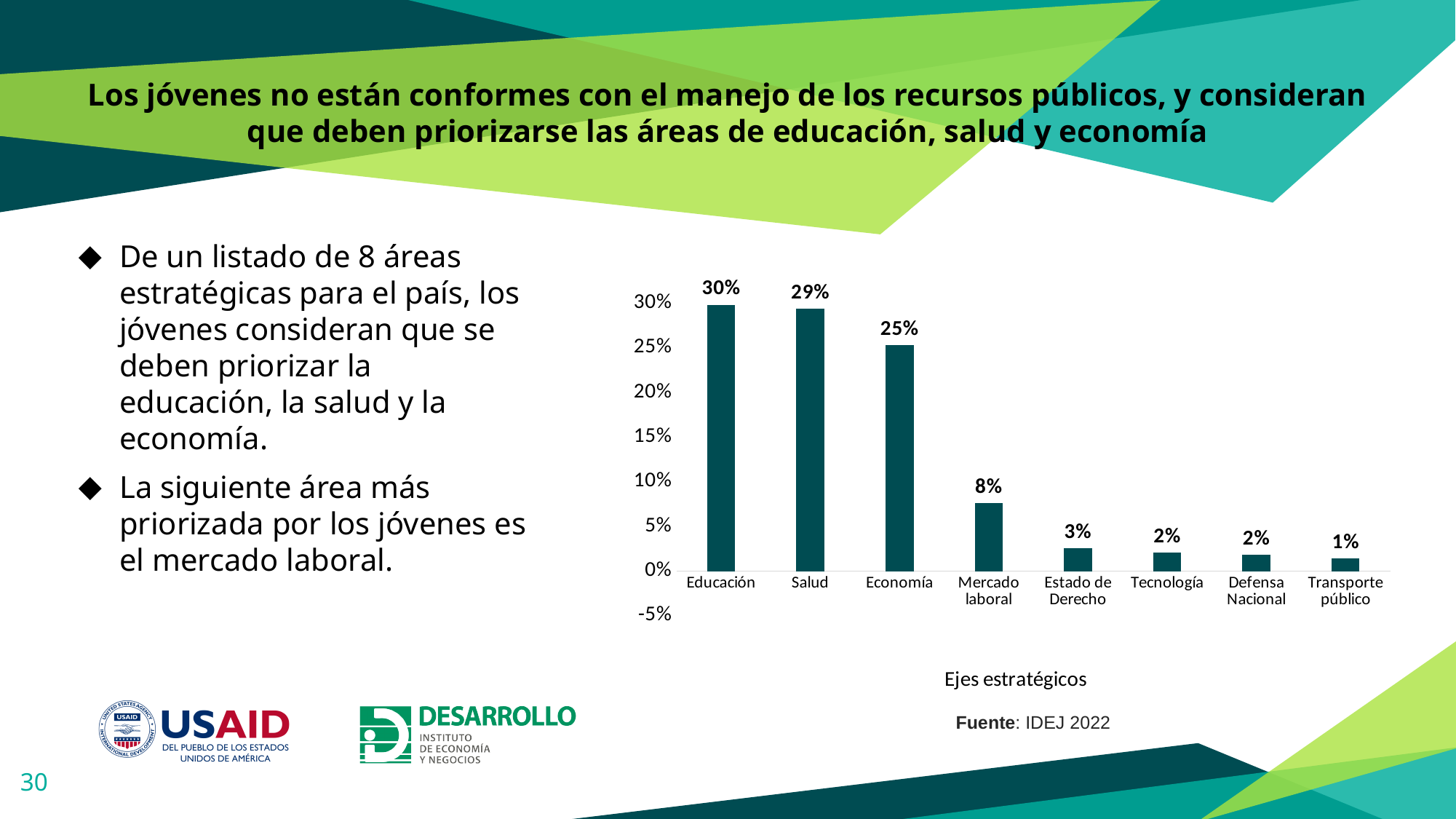
Which category has the highest value? Educación What is the value for Mercado laboral? 8% What is the x-axis title of the chart? Ejes estratégicos What is the difference between the values for Salud and Economía? 4% What is the value for Educación? 30% How many categories are shown on the x axis? 8 Do the values rise or fall from left to right along the x axis? Fall Which is larger, the value for Economía or the value for Mercado laboral? Economía What is the difference between the values for Educación and Mercado laboral? 22% What is the value for Estado de Derecho? 3% Which category has the lowest value? Transporte público What kind of chart is shown on the slide? Bar chart